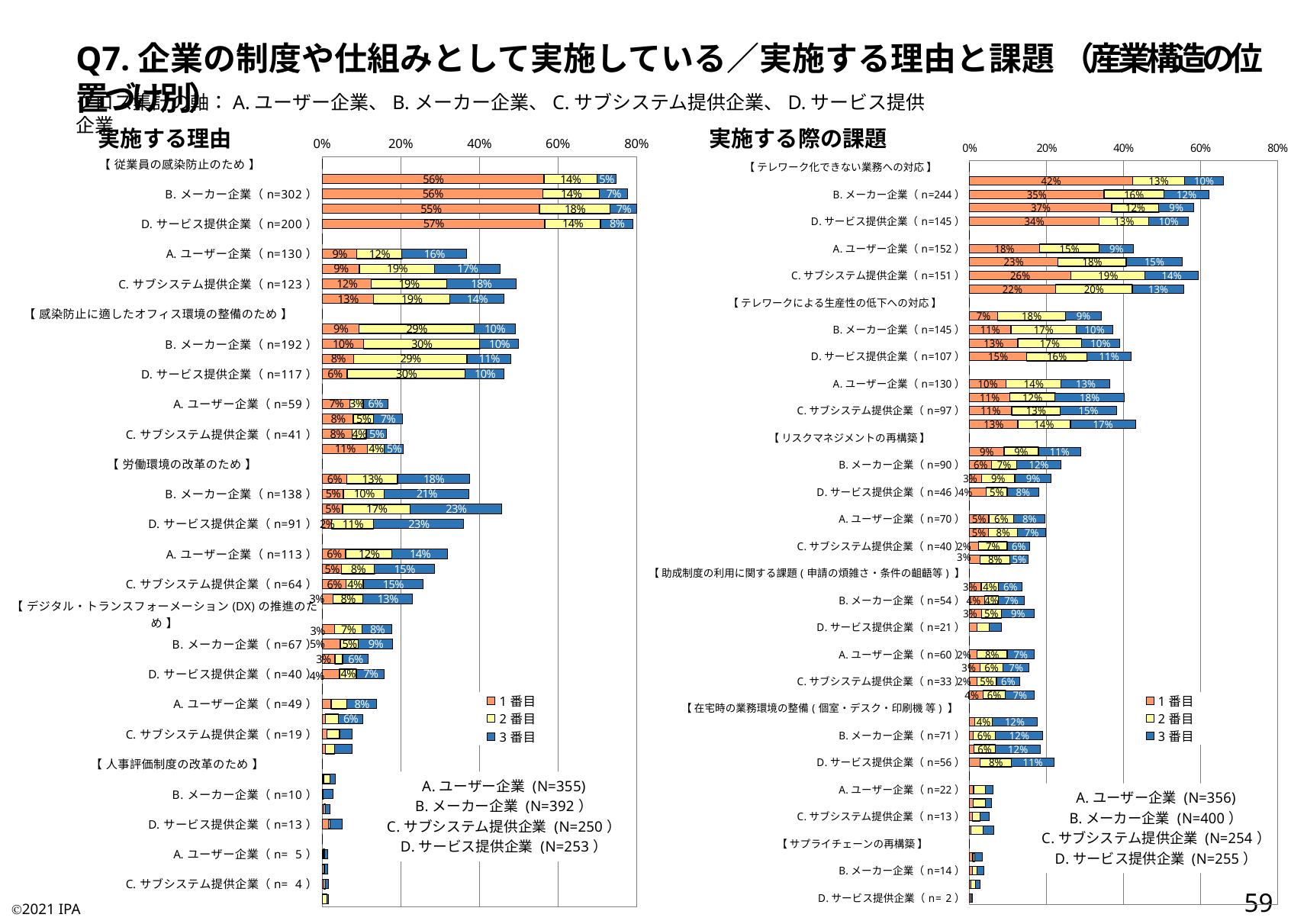
In the 実施する理由 chart, is the total bar for D. サービス提供企業 (n=200) under 従業員の感染防止のため greater or less than 60%? greater What are the three legend entries shown in the 実施する理由 chart? 1番目, 2番目, 3番目 In the 実施する理由 chart, what is the difference between the 1番目 and 2番目 values for B. メーカー企業 (n=302) under 従業員の感染防止のため? 42 percentage points In the 実施する際の課題 chart, what is the total of the stacked bar for D. サービス提供企業 (n=145) under テレワーク化できない業務への対応? 57% In the 実施する際の課題 chart, what is the 1番目 value for D. サービス提供企業 (n=145) under テレワーク化できない業務への対応? 34% In the 実施する際の課題 chart, what is the 2番目 value for B. メーカー企業 (n=244) under テレワーク化できない業務への対応? 16% In the 実施する際の課題 chart, which has the larger 1番目 value: B. メーカー企業 (n=244) under テレワーク化できない業務への対応 or B. メーカー企業 (n=145) under テレワークによる生産性の低下への対応? B. メーカー企業 (n=244) What kind of chart is the 実施する理由 chart on the left? Stacked horizontal bar chart In the 実施する理由 chart, what is the total of the stacked bar for B. メーカー企業 (n=302) under 従業員の感染防止のため? 77% How many series does the legend of the 実施する際の課題 chart list? 3 In the 実施する理由 chart, what is the 1番目 value for B. メーカー企業 (n=302) under 従業員の感染防止のため? 56% In the 実施する理由 chart, what is the 3番目 value for D. サービス提供企業 (n=200) under 従業員の感染防止のため? 8%